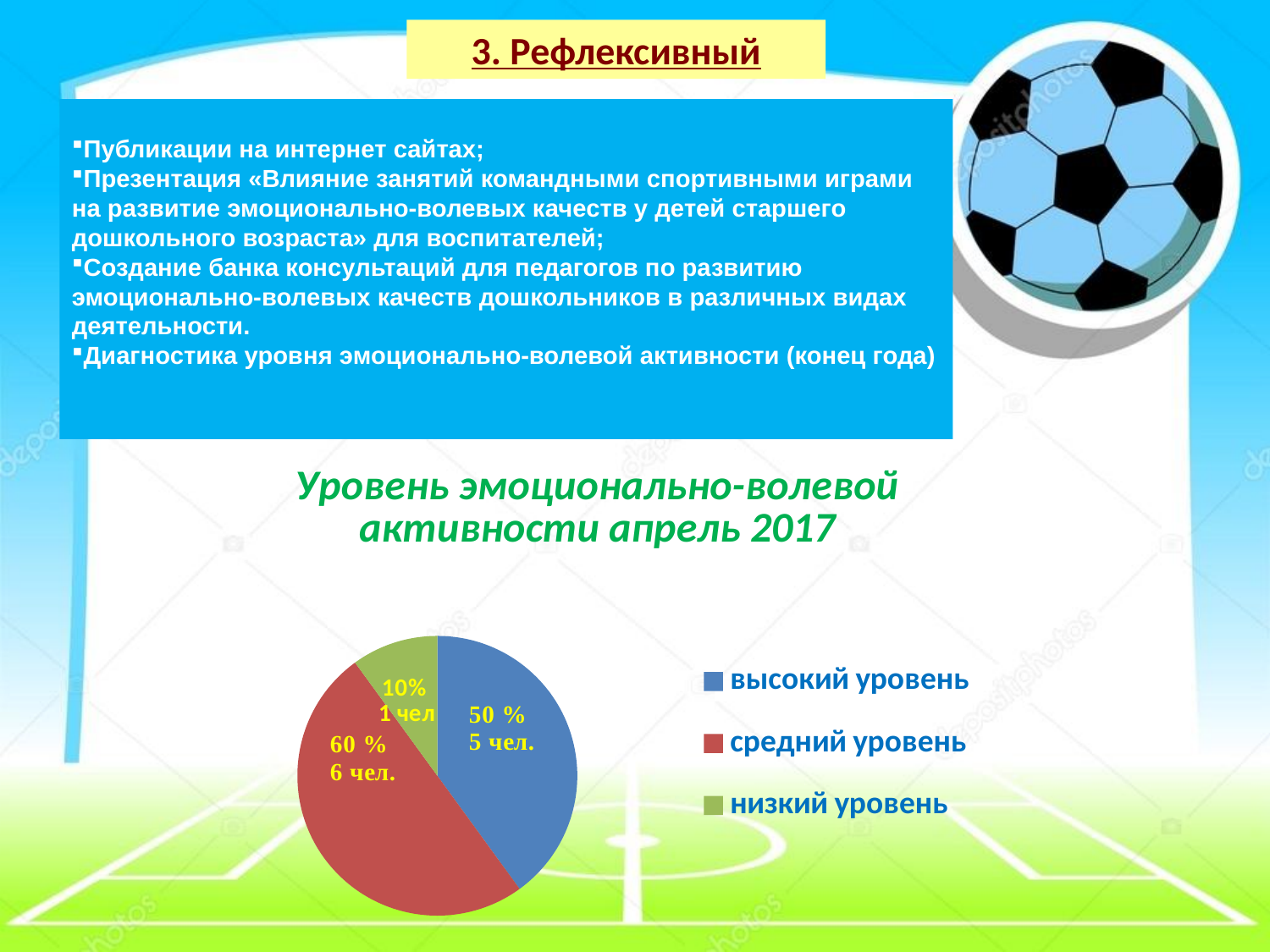
What kind of chart is shown on the slide? pie chart How many people (чел.) are shown for высокий уровень? 5 чел. How many people (чел.) are shown for средний уровень? 6 чел. Which level has the largest slice of the pie? средний уровень How many entries does the legend list? 3 What percentage is printed on the slice for низкий уровень? 10% What percentage is printed on the slice for средний уровень? 60 % What percentage is printed on the slice for высокий уровень? 50 % Which level has the smallest slice of the pie? низкий уровень Which colour represents низкий уровень in the legend? green How many slices does the pie chart have? 3 What is the title of the chart? Уровень эмоционально-волевой активности апрель 2017